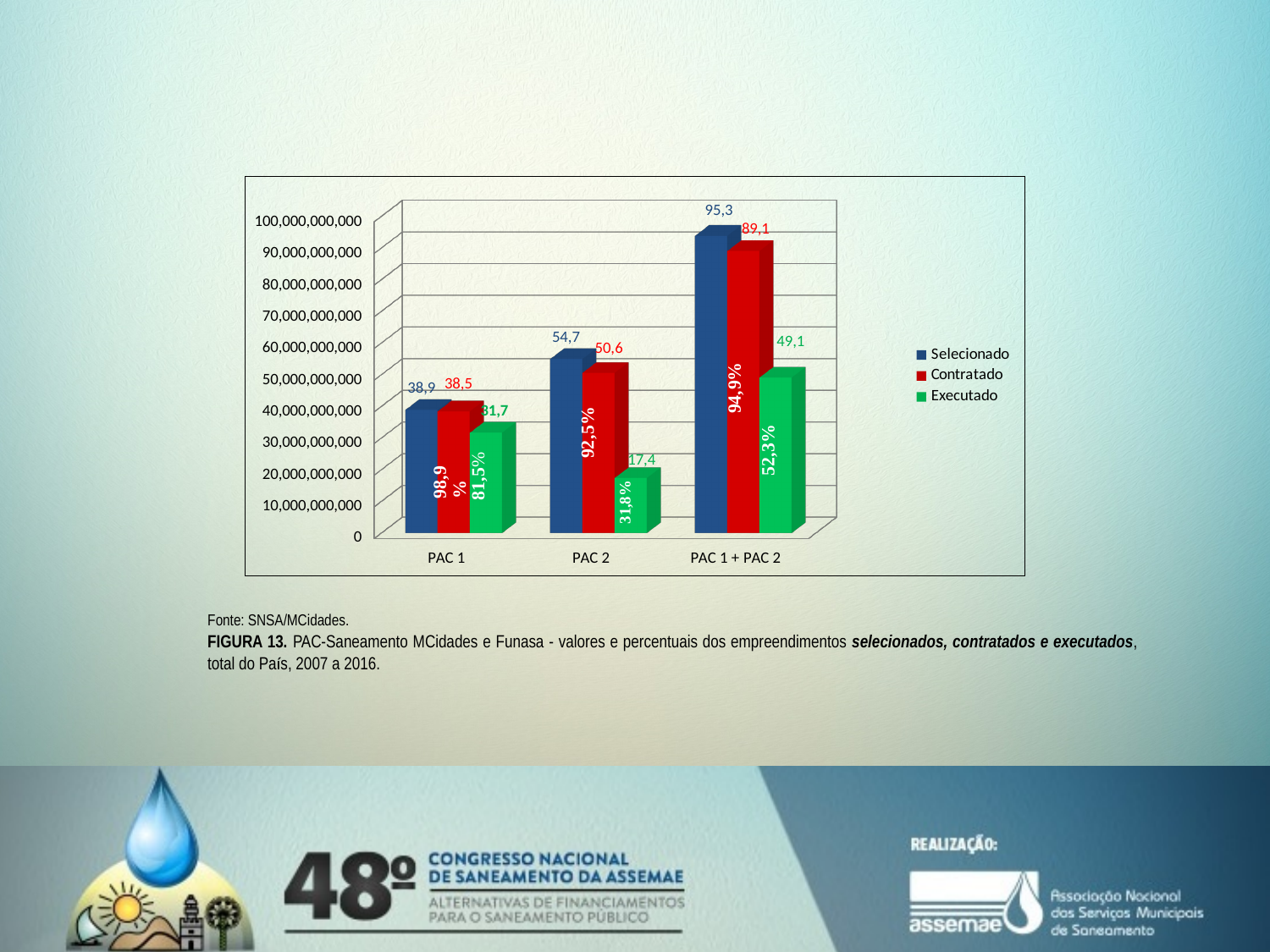
Which category has the lowest Executado value? PAC 2 How many series does the legend list? 3 What is the data label for Executado in the PAC 2 category? 17,4 How many categories are shown on the x axis? 3 Is the Selecionado bar for PAC 2 greater or less than 50,000,000,000? greater What is the data label for Selecionado in the PAC 1 + PAC 2 category? 95,3 What is the data label for Contratado in the PAC 1 category? 38,5 What is the difference between the Selecionado and Contratado data labels for PAC 1 + PAC 2? 6,2 What kind of chart is shown on the slide? Bar chart Which category has the highest Selecionado value? PAC 1 + PAC 2 Which is larger for PAC 2: the Contratado value or the Executado value? Contratado What percentage is printed inside the Executado bar for PAC 1 + PAC 2? 52,3%